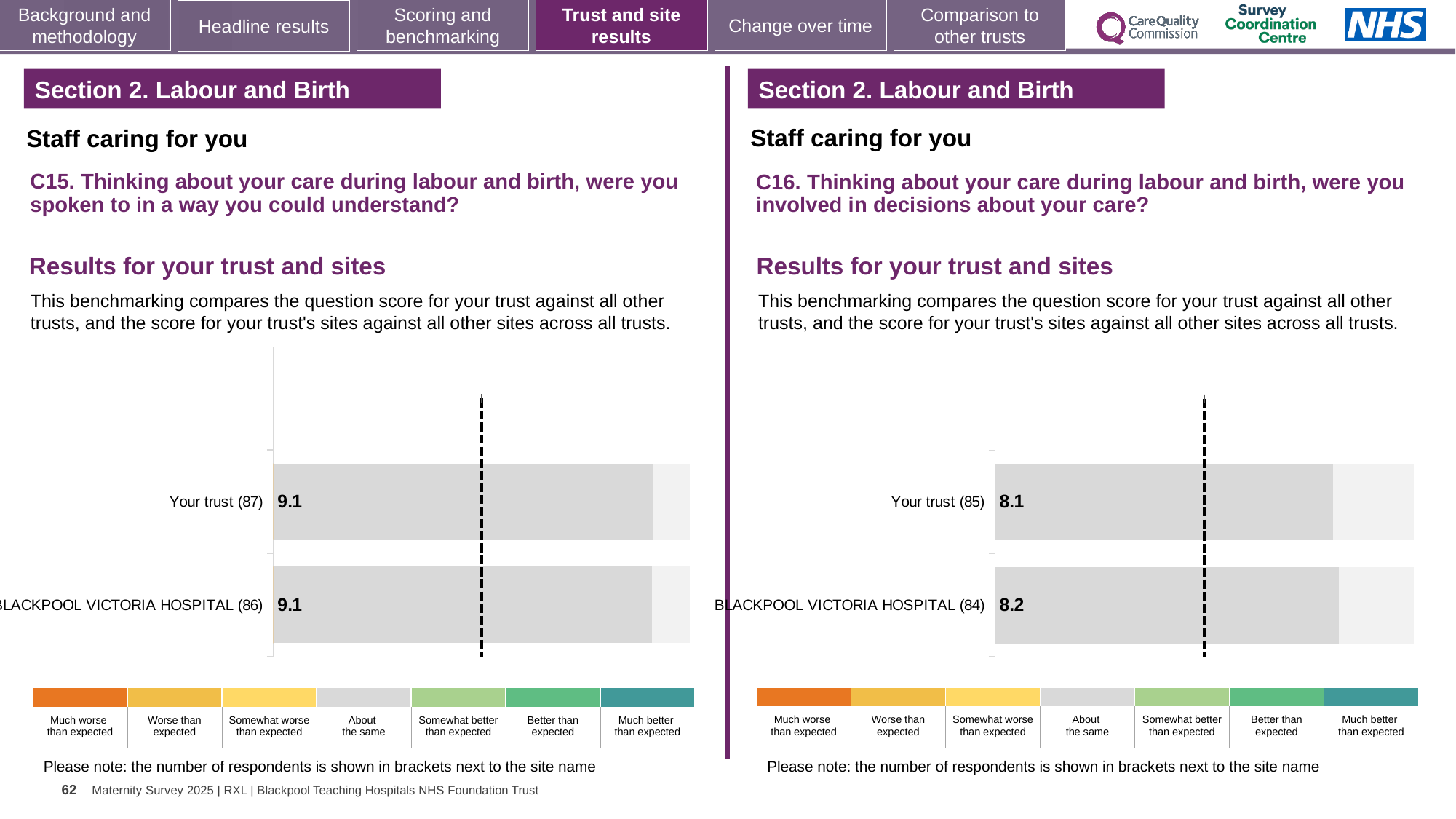
Is the Your trust score in the C15 chart on the left greater or less than the Your trust score in the C16 chart on the right? greater What kind of chart is used for the C16 results on the right? Bar chart In the C16 chart on the right, which has the higher score, Your trust or BLACKPOOL VICTORIA HOSPITAL? BLACKPOOL VICTORIA HOSPITAL In the C16 chart on the right, which category has the lowest score? Your trust In the C16 chart on the right, what is the difference between the BLACKPOOL VICTORIA HOSPITAL score and the Your trust score? 0.1 In the C15 chart on the left, what is the score for Your trust? 9.1 In the C15 chart on the left, what is the score for BLACKPOOL VICTORIA HOSPITAL? 9.1 In the C16 chart on the right, what is the score for BLACKPOOL VICTORIA HOSPITAL? 8.2 In the C15 chart on the left, how many respondents are shown in brackets for Your trust? 87 In the C16 chart on the right, how many respondents are shown in brackets for BLACKPOOL VICTORIA HOSPITAL? 84 In the C16 chart on the right, what is the score for Your trust? 8.1 How many bars are plotted in the C15 chart on the left? 2